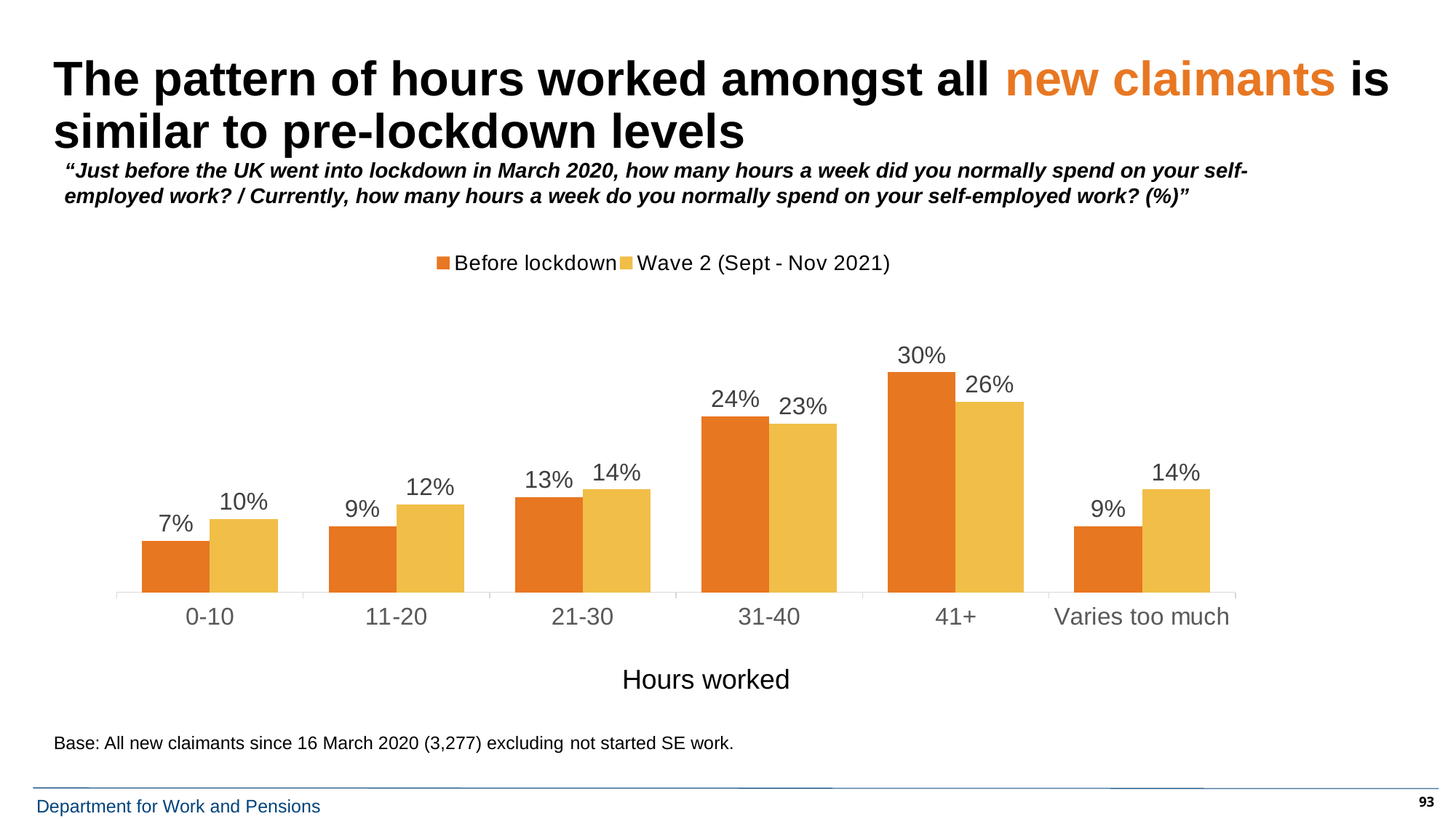
What is the Wave 2 (Sept - Nov 2021) value for the 0-10 hours category? 10% What kind of chart is shown on the slide? Bar chart Which hours worked category has the highest Before lockdown value? 41+ For the 11-20 hours category, which series has the larger value: Before lockdown or Wave 2 (Sept - Nov 2021)? Wave 2 (Sept - Nov 2021) What is the Wave 2 (Sept - Nov 2021) value for the Varies too much category? 14% What is the label of the x axis? Hours worked How many series does the legend list? 2 Which hours worked category has the lowest Before lockdown value? 0-10 Which series is shown in yellow? Wave 2 (Sept - Nov 2021) What is the difference between the Before lockdown and Wave 2 (Sept - Nov 2021) values for the 41+ category? 4 percentage points How many hours worked categories are shown on the x axis? 6 What is the Before lockdown value for the 31-40 hours category? 24%